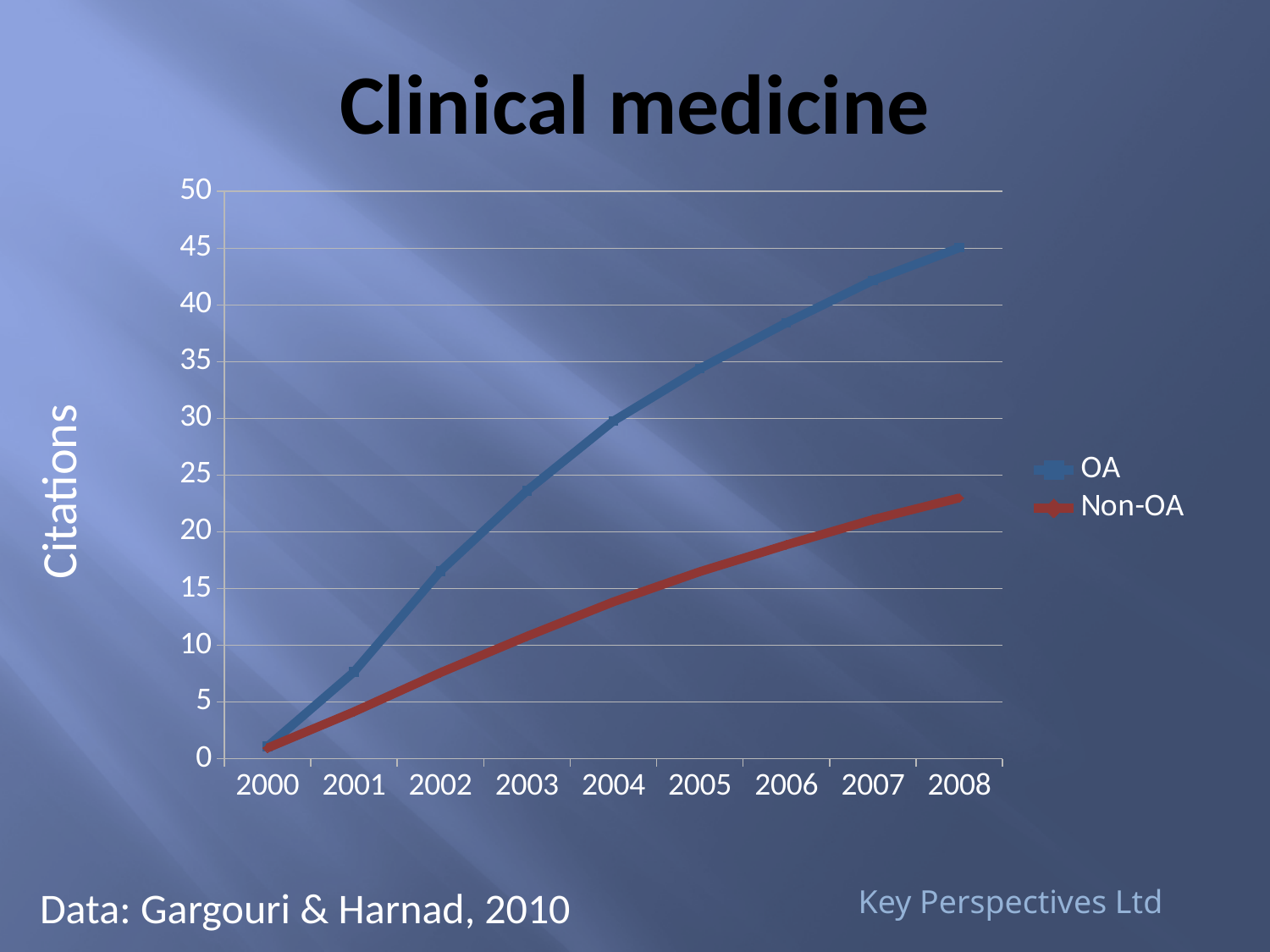
In which year does the OA series reach its highest value? 2008 Do the OA citations rise or fall from 2000 to 2008? rise Is the OA value for 2002 greater or less than 10? greater What kind of chart is shown on the slide? line chart Is the Non-OA value for 2004 greater or less than 20? less How many series does the legend list? 2 In 2008, which series has more citations, OA or Non-OA? OA Is the Non-OA value for 2008 greater or less than 25? less How many years are shown on the x axis? 9 What is the label on the y axis? Citations What is the title of the chart? Clinical medicine